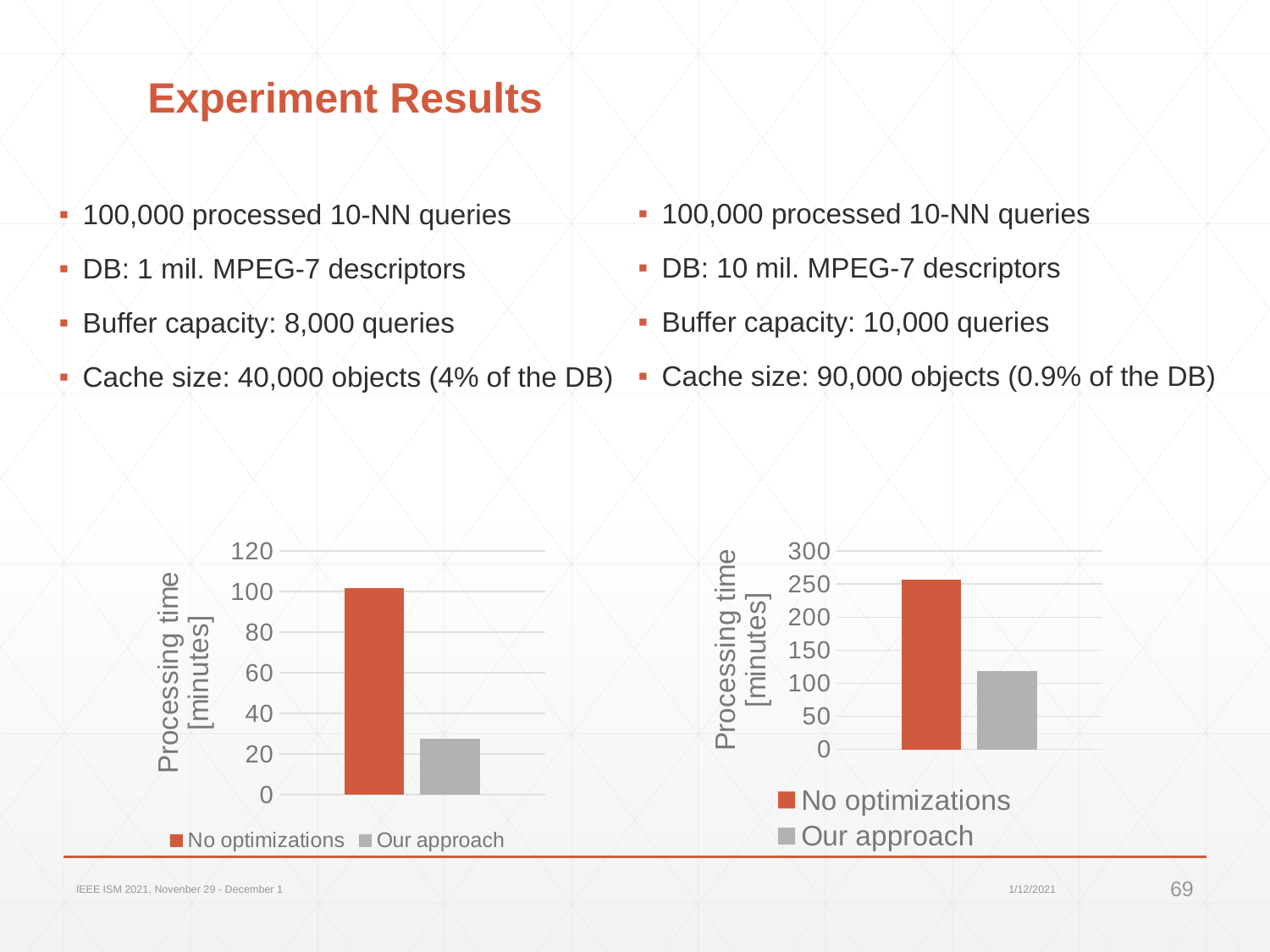
In the right chart, is the value for No optimizations greater or less than 200? greater What kind of chart is the left chart on the slide? bar chart In the left chart, is the value for Our approach greater or less than 40? less In the left chart, what colour is the bar for Our approach? grey In the right chart, is the value for Our approach greater or less than 150? less How many series does the legend of the right chart list? 2 How many series does the legend of the left chart list? 2 What is the y-axis title of the right chart? Processing time [minutes] In the right chart, which series has the shorter bar, No optimizations or Our approach? Our approach What kind of chart is the right chart on the slide? bar chart In the left chart, which series has the taller bar, No optimizations or Our approach? No optimizations